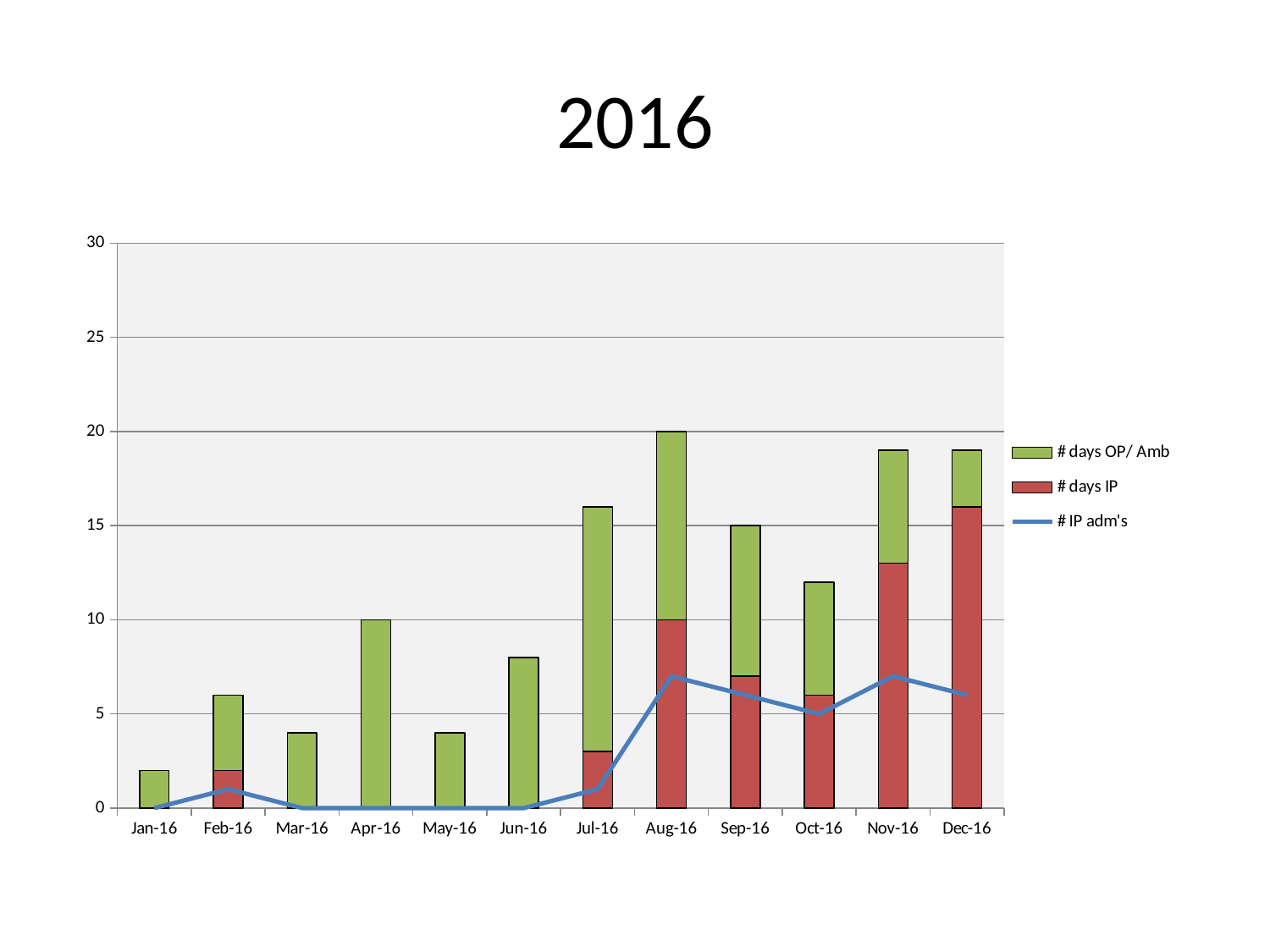
Which month has the highest value for # days IP? Dec-16 How many series does the legend list? 3 What is the total height of the stacked bar for Aug-16? 20 How many months are shown on the x axis? 12 What is the value of # days OP/ Amb for Apr-16? 10 Which month has the shortest stacked bar? Jan-16 What is the value of # IP adm's for Jan-16? 0 What is the value of # IP adm's for Oct-16? 5 Which month has the tallest stacked bar? Aug-16 Is the total stacked bar for Jul-16 greater or less than 15? greater What is the value of # days IP for Aug-16? 10 Is the value of # days IP for Dec-16 greater or less than 15? greater